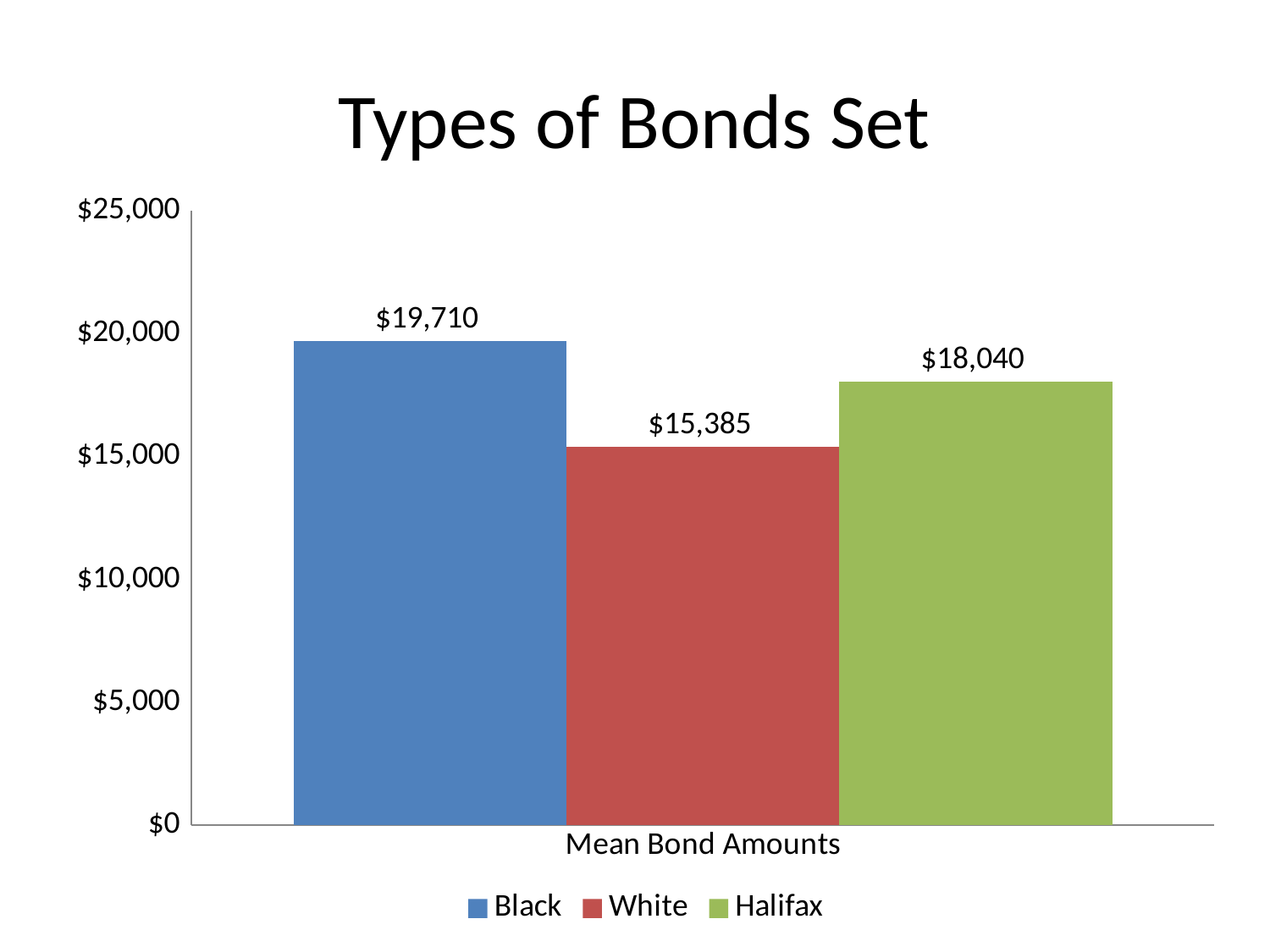
What is the difference between the mean bond amounts for Black and White? $4,325 Which series has the highest mean bond amount? Black Which series has the lowest mean bond amount? White What is the title of the chart? Types of Bonds Set Is the mean bond amount for Black greater or less than $20,000? less What kind of chart is shown on the slide? bar chart Which is larger, the mean bond amount for Halifax or for White? Halifax What is the mean bond amount for White? $15,385 How many series does the legend list? 3 What is the mean bond amount for Black? $19,710 What is the difference between the mean bond amounts for Halifax and White? $2,655 What is the mean bond amount for Halifax? $18,040